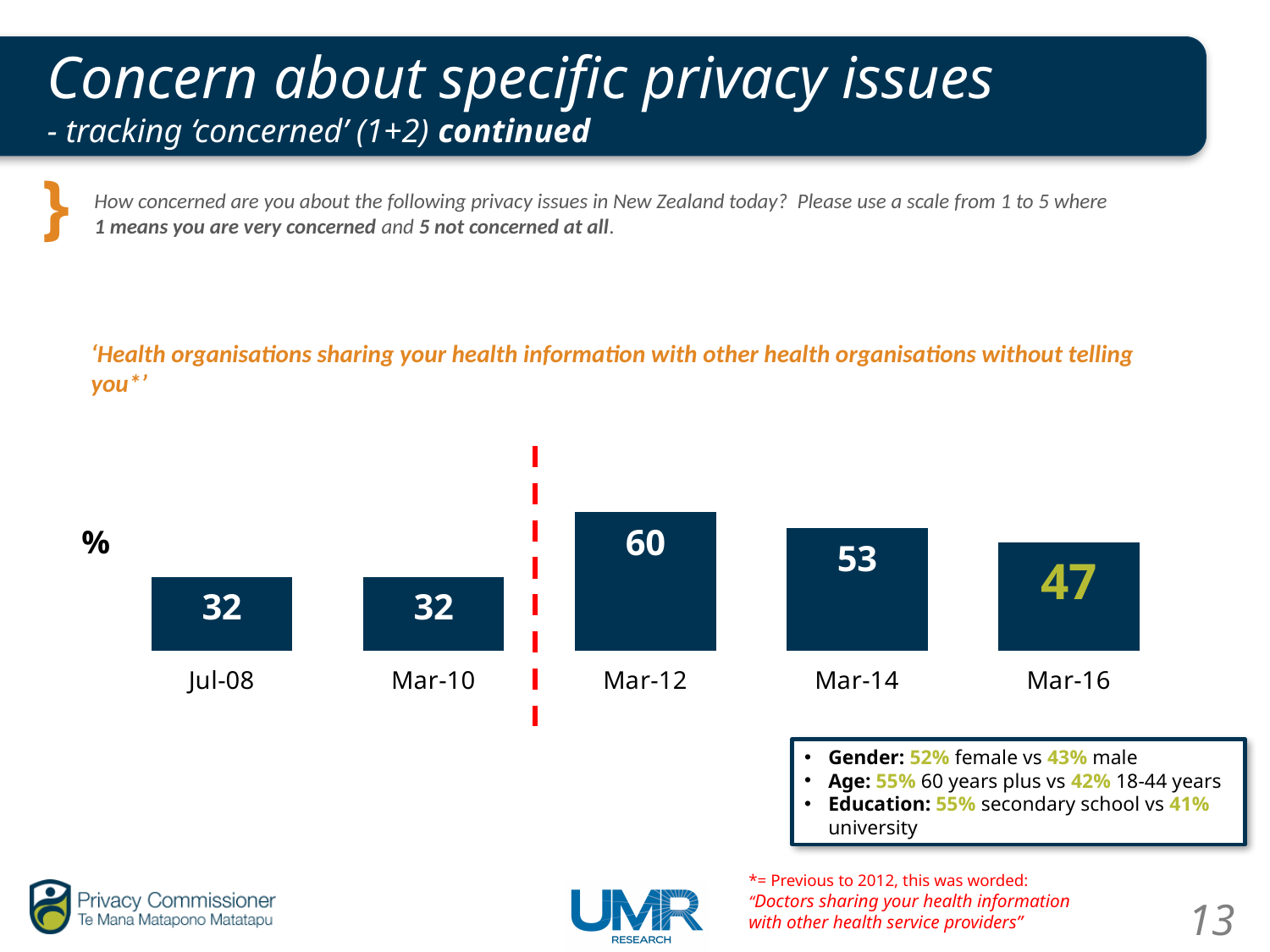
What kind of chart is shown on the slide? Bar chart How many time periods are shown on the chart? 5 Do the values rise or fall from Mar-12 to Mar-16? Fall What unit is indicated on the chart's axis label? % What is the value for Mar-12? 60 What is the difference between the values for Mar-14 and Mar-10? 21 Which period has the highest value? Mar-12 What is the value for Jul-08? 32 What is the difference between the values for Mar-12 and Mar-16? 13 What is the value for Mar-16? 47 Which two periods have the same value? Jul-08 and Mar-10 Which is larger, the value for Mar-14 or the value for Mar-16? Mar-14